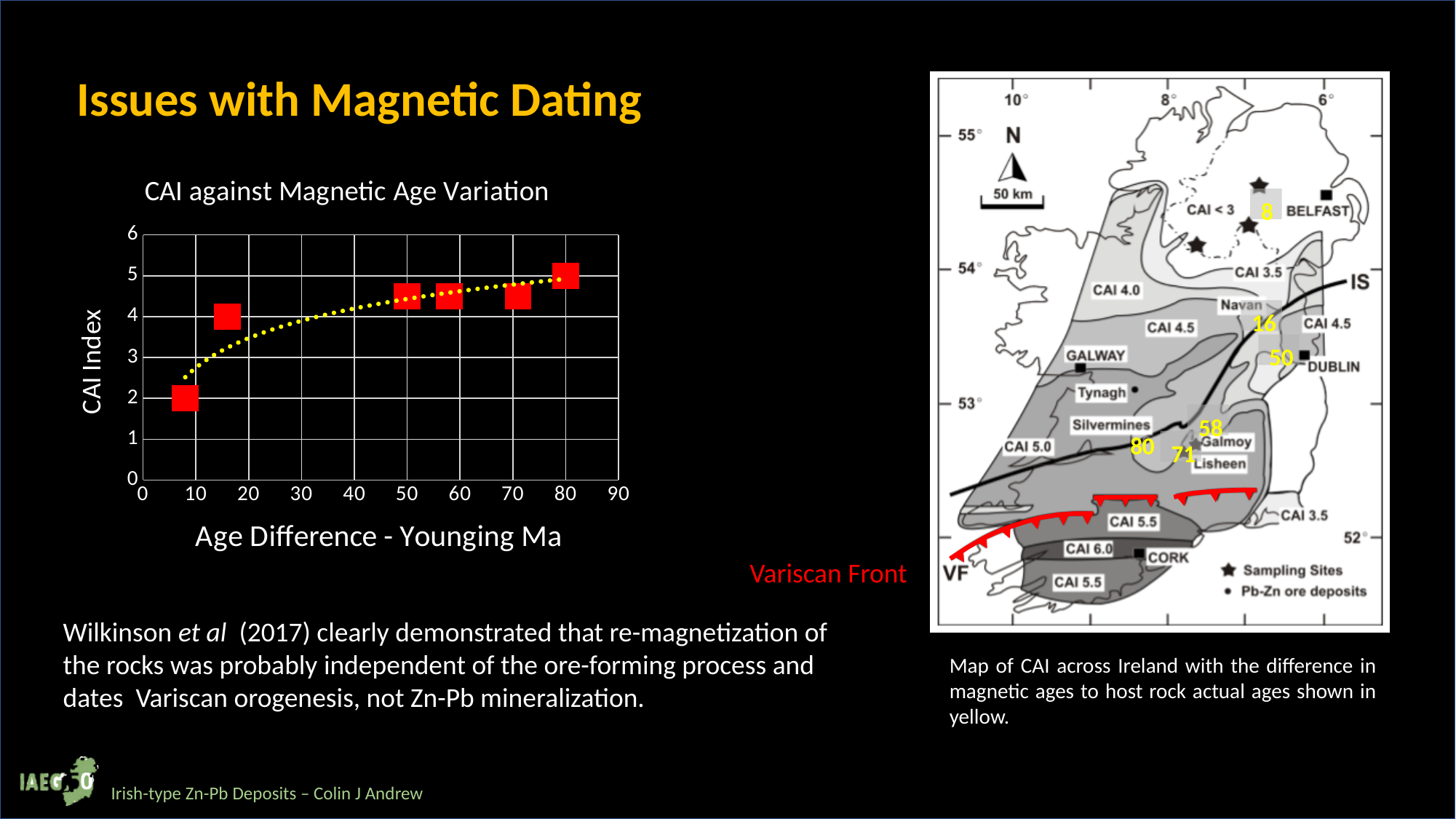
What is the y-axis title of the 'CAI against Magnetic Age Variation' chart? CAI Index How many data points are plotted in the 'CAI against Magnetic Age Variation' chart? 6 In the 'CAI against Magnetic Age Variation' chart, which has the higher CAI Index: the leftmost point or the rightmost point? the rightmost point In the 'CAI against Magnetic Age Variation' chart, does the point with the lowest CAI Index lie at the smallest or the largest age difference? smallest In the 'CAI against Magnetic Age Variation' chart, is the CAI Index of the rightmost point (largest age difference) greater or less than 4? greater In the 'CAI against Magnetic Age Variation' chart, does the CAI Index generally rise or fall as the age difference increases? rise What is the x-axis title of the 'CAI against Magnetic Age Variation' chart? Age Difference - Younging Ma What kind of chart is 'CAI against Magnetic Age Variation'? scatter chart In the 'CAI against Magnetic Age Variation' chart, is the CAI Index of the leftmost point (smallest age difference) greater or less than 3? less In the 'CAI against Magnetic Age Variation' chart, does the point with the highest CAI Index lie at the smallest or the largest age difference? largest In the 'CAI against Magnetic Age Variation' chart, is the CAI Index of the point near an age difference of 50 greater or less than 4? greater